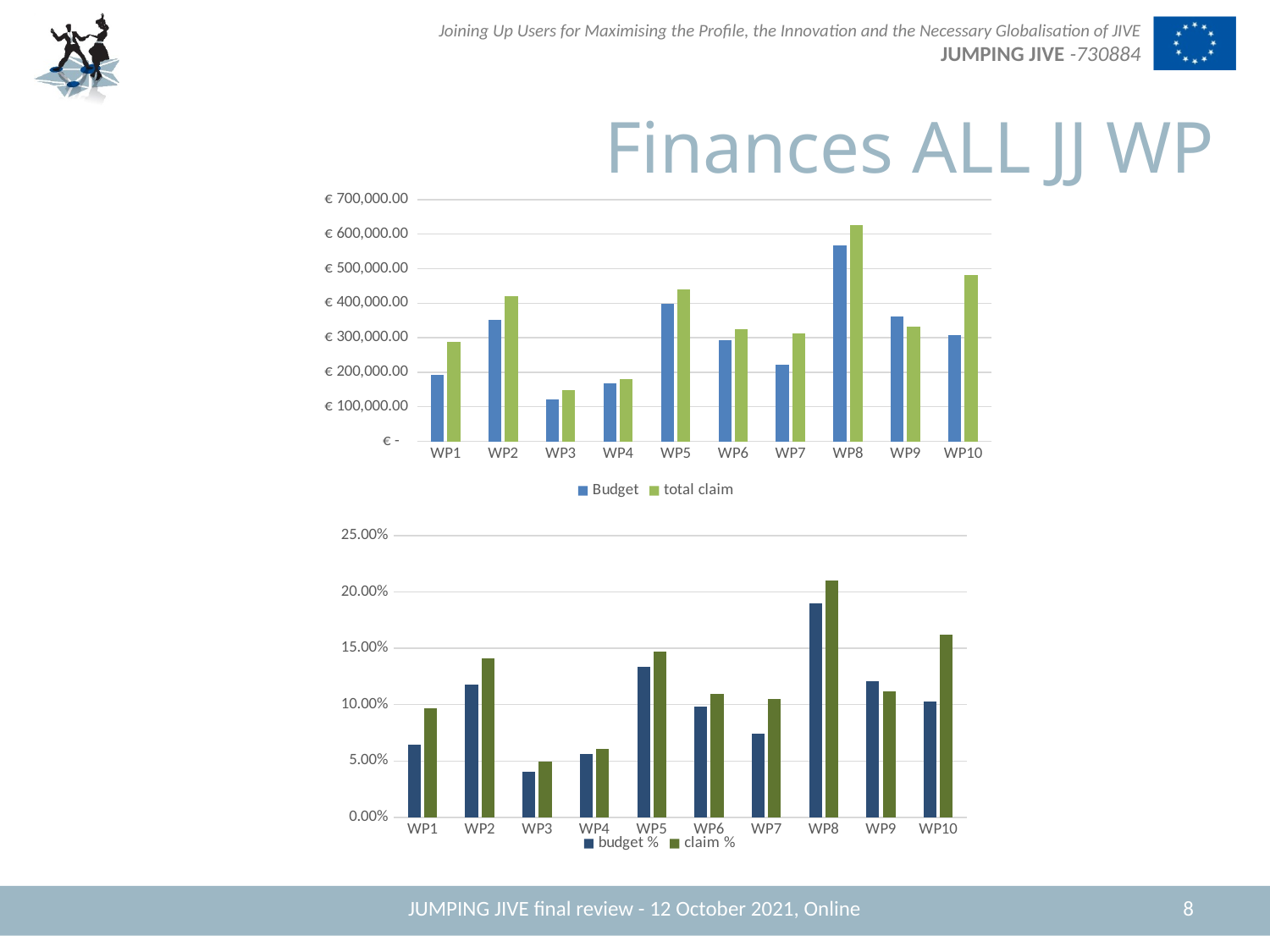
On the bottom chart, what are the two series named in the legend? budget % and claim % On the top chart, is the total claim for WP3 greater or less than € 200,000.00? less What kind of chart is the top chart? bar chart On the top chart, which work package has the lowest total claim? WP3 On the bottom chart, is the claim % for WP10 greater or less than 15.00%? greater On the top chart, for WP10, which is larger: Budget or total claim? total claim On the top chart, is the Budget for WP8 greater or less than € 500,000.00? greater On the bottom chart, which work package has the lowest budget %? WP3 On the top chart, how many series does the legend list? 2 On the top chart, how many work packages are shown on the x axis? 10 On the top chart, which work package has the highest Budget? WP8 On the bottom chart, which work package has the highest claim %? WP8